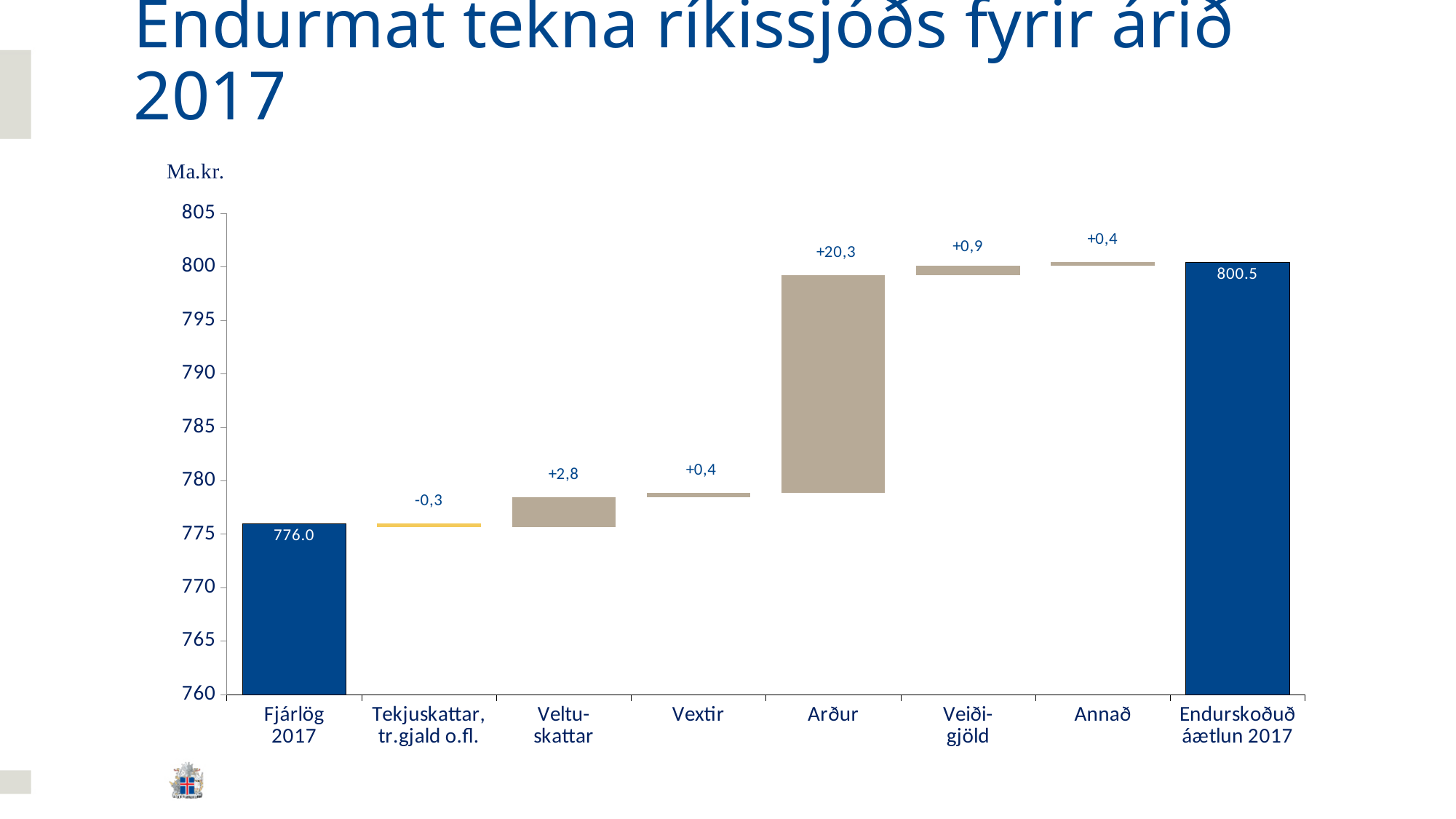
Which change is larger, Veiðigjöld or Vextir? Veiðigjöld What is the change shown for Tekjuskattar, tr.gjald o.fl.? -0,3 What is the difference between Endurskoðuð áætlun 2017 and Fjárlög 2017? 24.5 What is the value for Endurskoðuð áætlun 2017? 800.5 What is the change shown for Veltuskattar? +2,8 What is the value for Fjárlög 2017? 776.0 What unit is shown above the y axis? Ma.kr. Which category shows the largest positive change? Arður How many categories are shown on the x axis? 8 What is the change shown for Arður? +20,3 What kind of chart is shown on the slide? Bar chart (waterfall) Which category shows the only negative change? Tekjuskattar, tr.gjald o.fl.